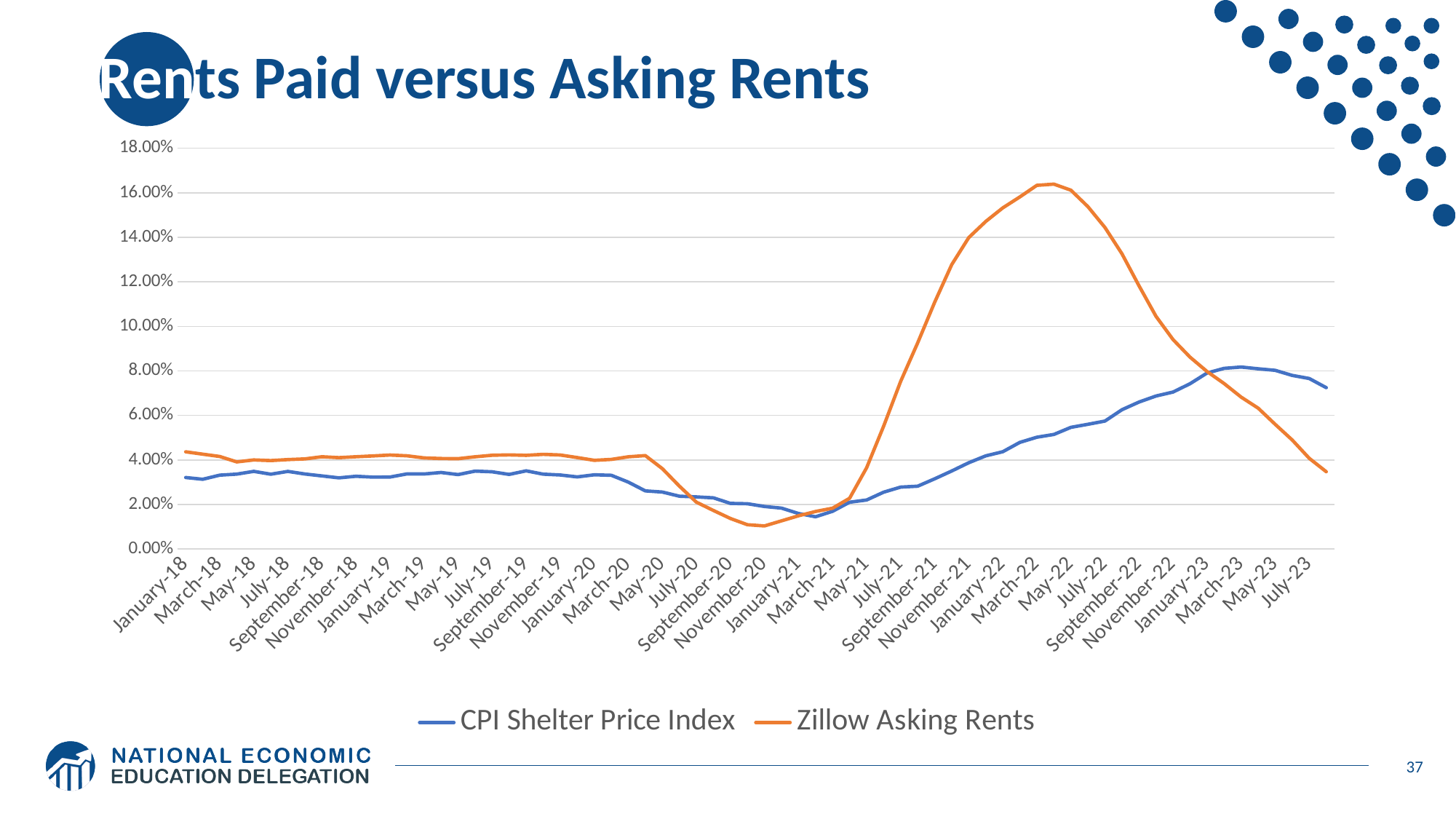
Which series is drawn in orange? Zillow Asking Rents How many series does the legend list? 2 What kind of chart is shown on the slide? Line chart What is the title of the chart? Rents Paid versus Asking Rents Is the value for CPI Shelter Price Index at March-23 greater or less than 6.00%? greater Is the value for Zillow Asking Rents at November-20 greater or less than 2.00%? less Which series reaches the highest value anywhere on the chart? Zillow Asking Rents Which series reaches the lowest value anywhere on the chart? Zillow Asking Rents At July-23, which series has the higher value, CPI Shelter Price Index or Zillow Asking Rents? CPI Shelter Price Index Is the value for CPI Shelter Price Index at March-22 greater or less than 6.00%? less Does the Zillow Asking Rents series rise or fall between March-22 and July-23? fall